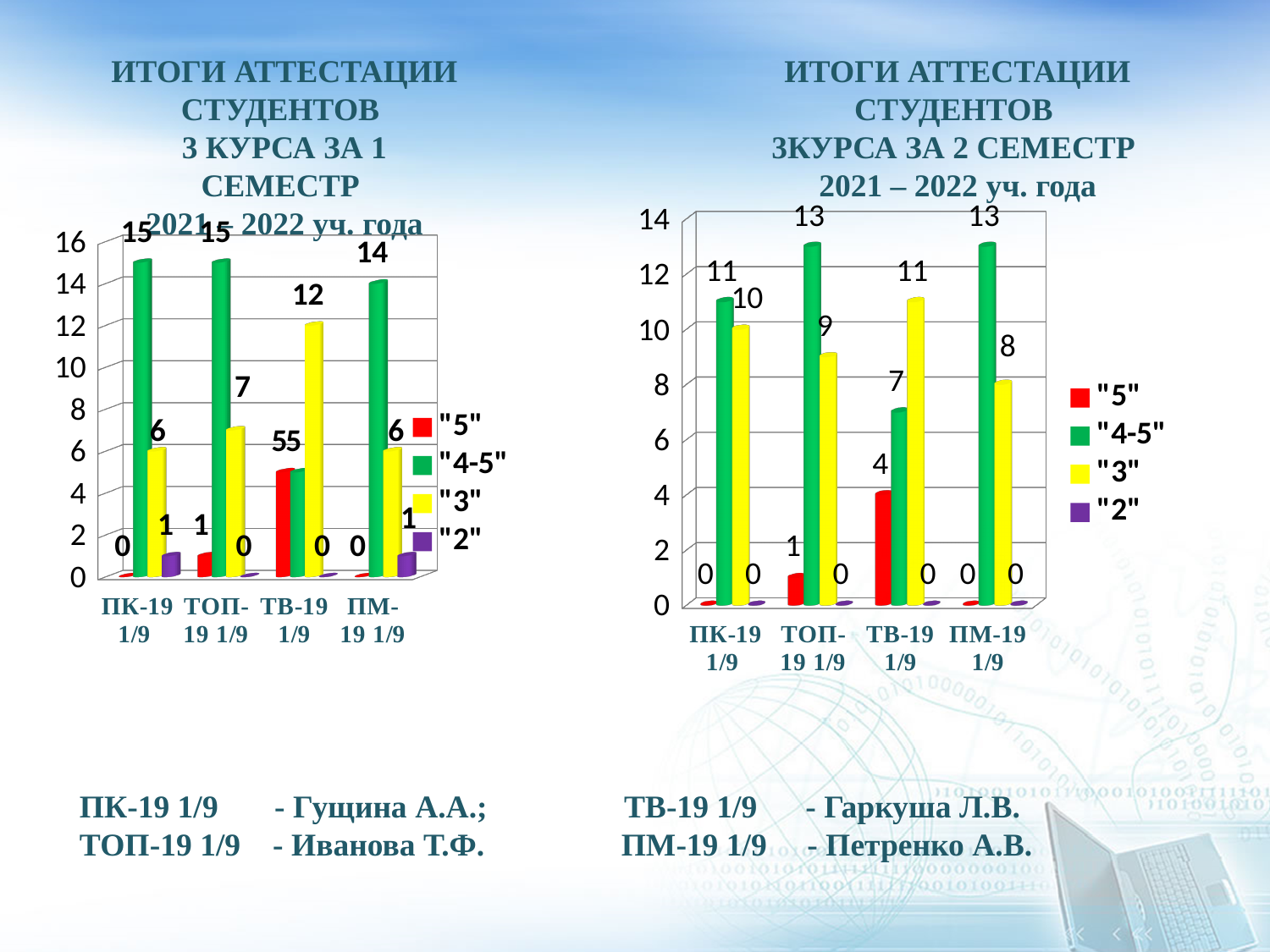
On the left chart (1st semester), what is the value of "4-5" for ПК-19 1/9? 15 On the right chart (2nd semester), what is the value of "5" for ТВ-19 1/9? 4 How many series does the legend of the left chart (1st semester) list? 4 On the right chart (2nd semester), what is the value of "3" for ПК-19 1/9? 10 On the right chart (2nd semester), which group has the highest "3" value? ТВ-19 1/9 On the left chart (1st semester), which is larger: the "3" value for ТОП-19 1/9 or for ПМ-19 1/9? ТОП-19 1/9 What type of chart is the right chart (2nd semester)? bar chart On the right chart (2nd semester), which group has the lowest "4-5" value? ТВ-19 1/9 On the right chart (2nd semester), what is the difference between the "4-5" values for ТОП-19 1/9 and ТВ-19 1/9? 6 On the left chart (1st semester), what is the value of "4-5" for ПМ-19 1/9? 14 How many groups are shown on the x axis of the right chart (2nd semester)? 4 On the left chart (1st semester), what is the value of "3" for ТВ-19 1/9? 12